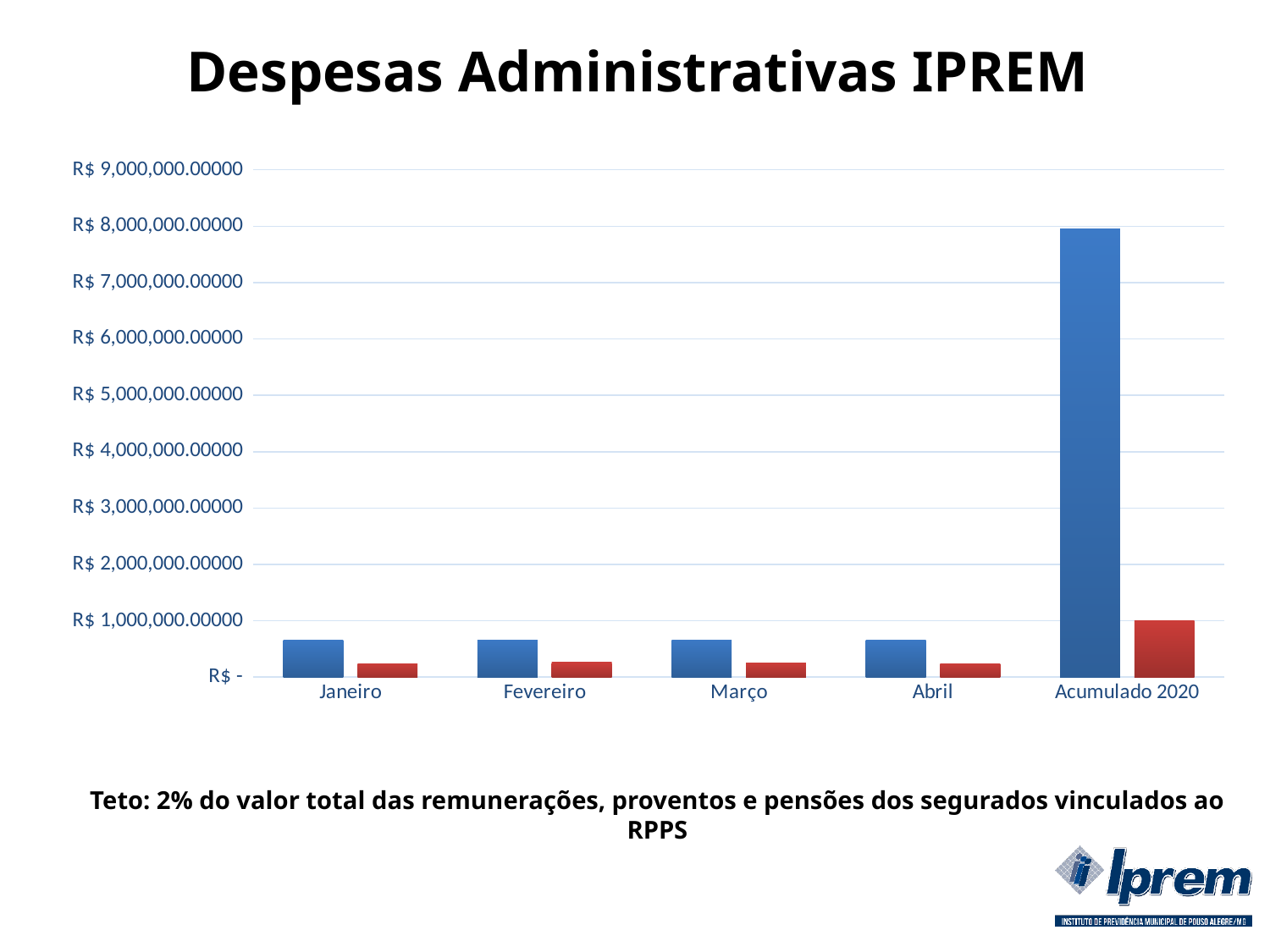
How many bars are shown for each category on the x axis? 2 How many categories are shown on the x axis of the chart? 5 Is the red bar for Março greater or less than R$ 1,000,000.00000? less In Fevereiro, which bar is taller, the blue one or the red one? the blue one Is the blue bar for Janeiro greater or less than R$ 1,000,000.00000? less Is the blue bar for Acumulado 2020 greater or less than R$ 7,000,000.00000? greater What is the title of the chart? Despesas Administrativas IPREM Which category has the tallest blue bar? Acumulado 2020 Which blue bar is taller, Abril or Acumulado 2020? Acumulado 2020 Which category has the tallest red bar? Acumulado 2020 What kind of chart is shown on the slide? bar chart